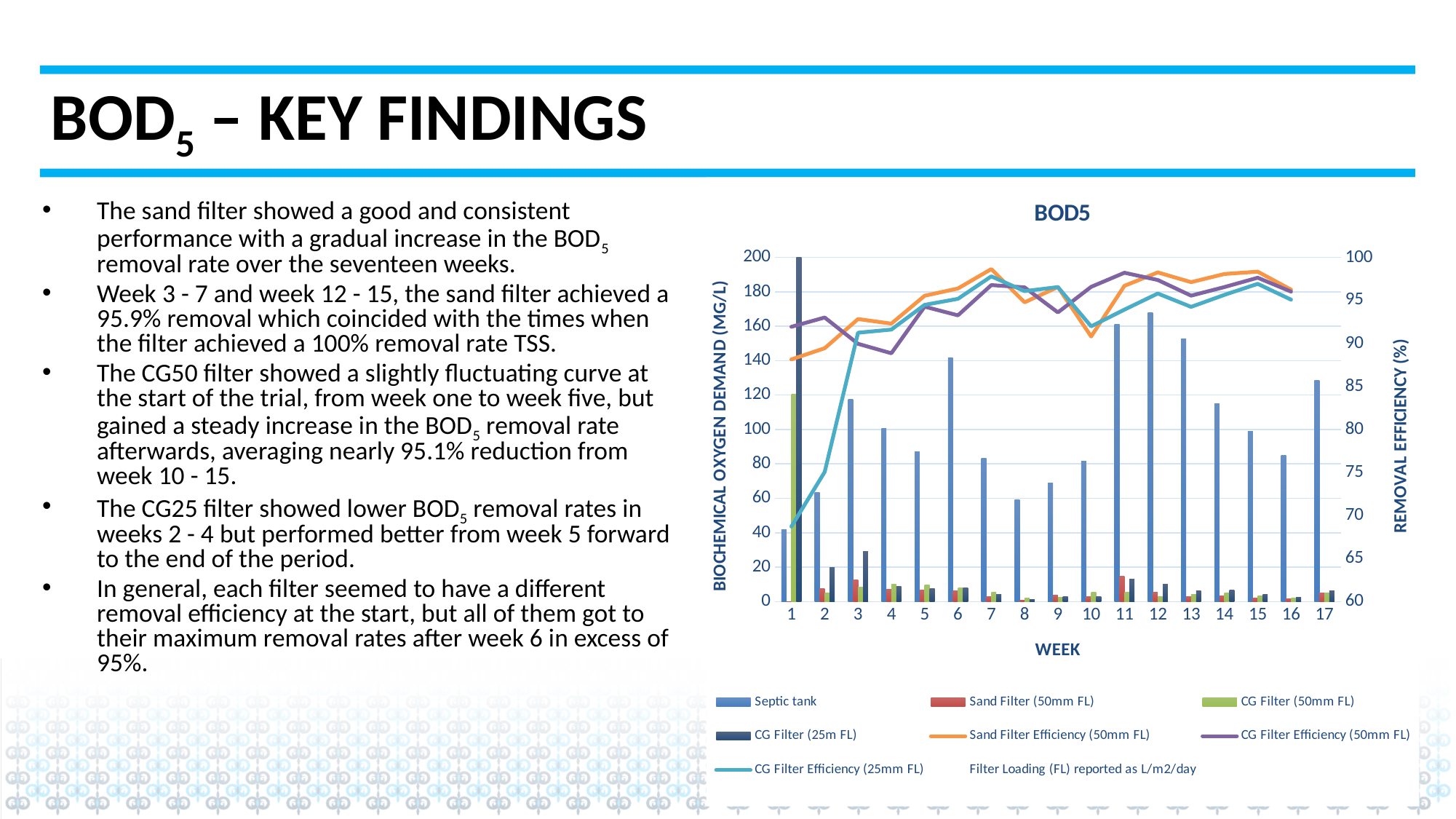
How many weeks are plotted along the x axis of the BOD5 chart? 17 In which week is the Septic tank bar lowest? Week 1 Which is larger, the Septic tank value for week 3 or for week 4? Week 3 What is the title of the left vertical axis of the chart? BIOCHEMICAL OXYGEN DEMAND (MG/L) What kind of chart is shown on the slide? A combined bar and line chart Does the CG Filter Efficiency (25mm FL) line rise or fall from week 1 to week 7? Rise Is the Septic tank value for week 1 greater or less than 60? less Is the CG Filter (25m FL) value for week 1 greater or less than 180? greater What is the title of the chart? BOD5 Is the Septic tank value for week 13 greater or less than 140? greater How many series does the legend of the BOD5 chart list? 8